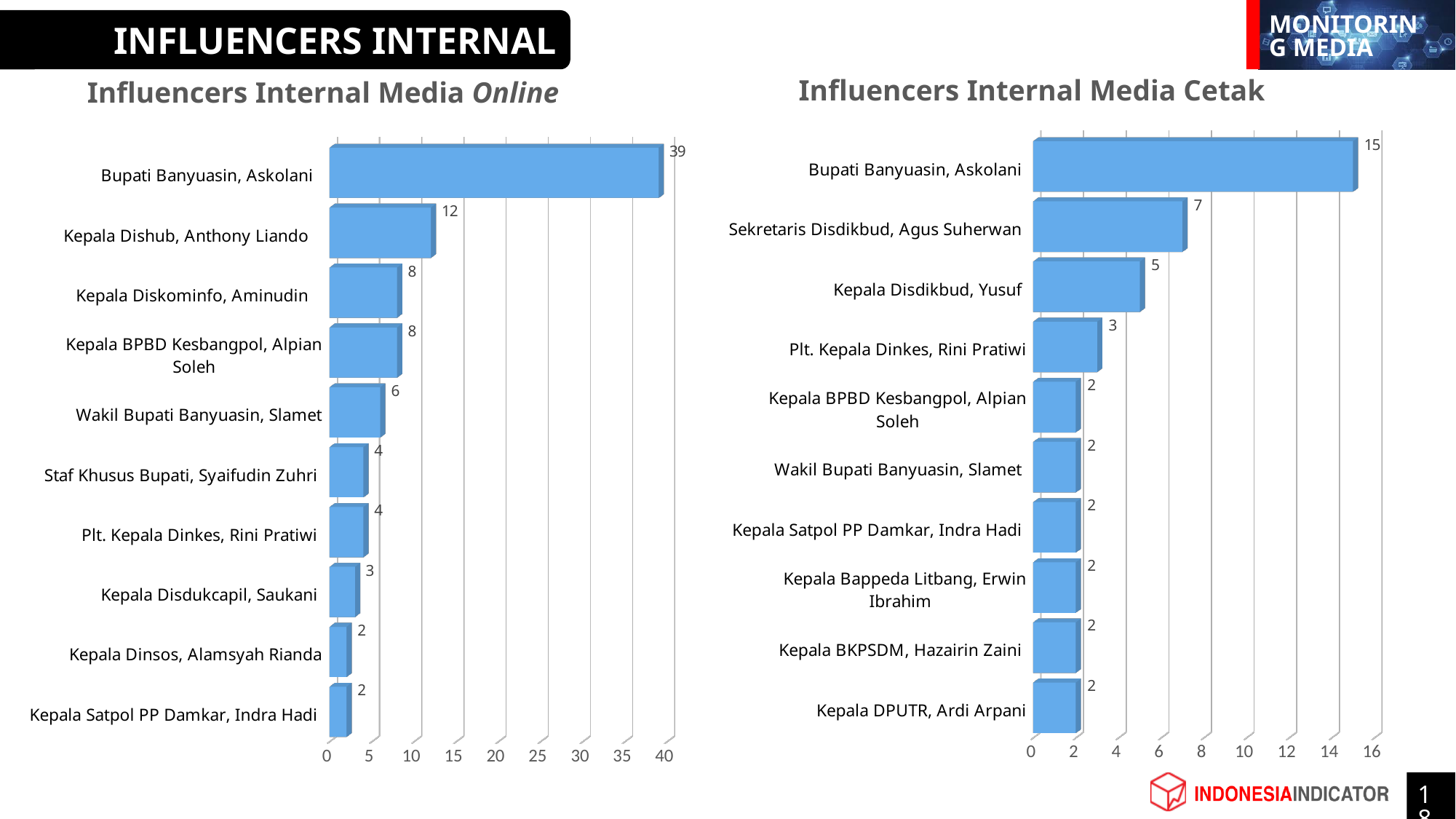
What kind of chart is the 'Influencers Internal Media Cetak' chart? Bar chart In the 'Influencers Internal Media Online' chart, what is the value for Kepala Dishub, Anthony Liando? 12 In the 'Influencers Internal Media Cetak' chart, which is larger: Plt. Kepala Dinkes, Rini Pratiwi or Kepala BKPSDM, Hazairin Zaini? Plt. Kepala Dinkes, Rini Pratiwi In the 'Influencers Internal Media Online' chart, which is larger: Wakil Bupati Banyuasin, Slamet or Kepala Disdukcapil, Saukani? Wakil Bupati Banyuasin, Slamet In the 'Influencers Internal Media Cetak' chart, what is the value for Sekretaris Disdikbud, Agus Suherwan? 7 In the 'Influencers Internal Media Online' chart, what is the value for Plt. Kepala Dinkes, Rini Pratiwi? 4 In the 'Influencers Internal Media Online' chart, what is the value for Bupati Banyuasin, Askolani? 39 In the 'Influencers Internal Media Cetak' chart, what is the difference between Bupati Banyuasin, Askolani and Kepala Disdikbud, Yusuf? 10 In the 'Influencers Internal Media Online' chart, which category has the lowest value? Kepala Dinsos, Alamsyah Rianda and Kepala Satpol PP Damkar, Indra Hadi (both 2) How many categories are shown in the 'Influencers Internal Media Online' chart? 10 In the 'Influencers Internal Media Online' chart, what is the difference between Bupati Banyuasin, Askolani and Kepala Dishub, Anthony Liando? 27 In the 'Influencers Internal Media Cetak' chart, which category has the highest value? Bupati Banyuasin, Askolani